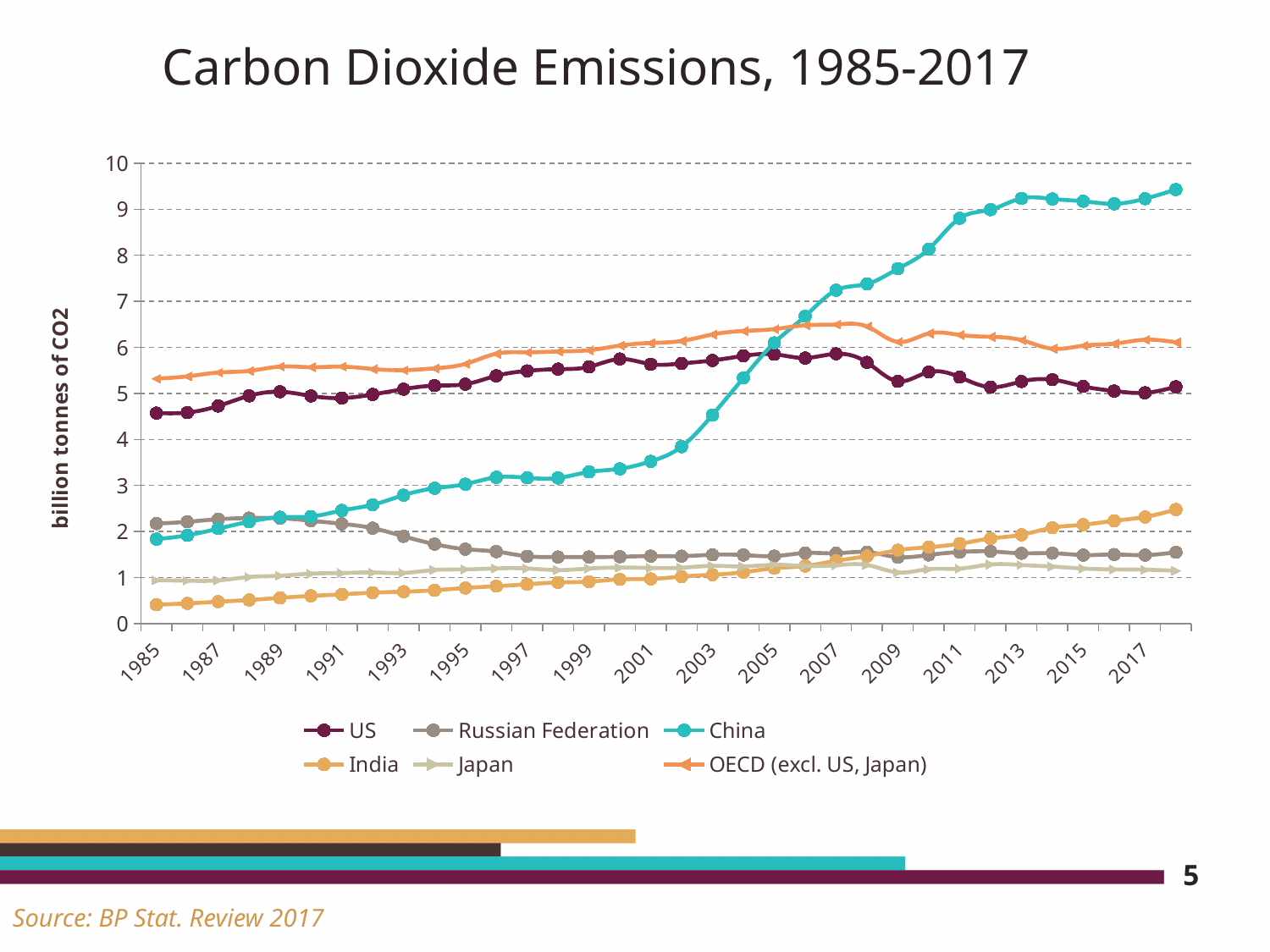
In 2017, which is larger, the value for OECD (excl. US, Japan) or the value for the US? OECD (excl. US, Japan) Which series has the highest value in 2017? China Is the value for India in 1985 greater or less than 1? less Is the value for China in 2017 greater or less than 9? greater Is the value for the US in 2017 greater or less than 6? less Do China's emissions rise or fall from 1985 to 2017? rise Which series has the highest value in 1985? OECD (excl. US, Japan) Which series has the lowest value in 2017? Japan How many series does the legend list? 6 What is the label on the vertical axis? billion tonnes of CO2 In 1985, which is larger, the value for the US or the value for China? US What kind of chart is shown on the slide? line chart